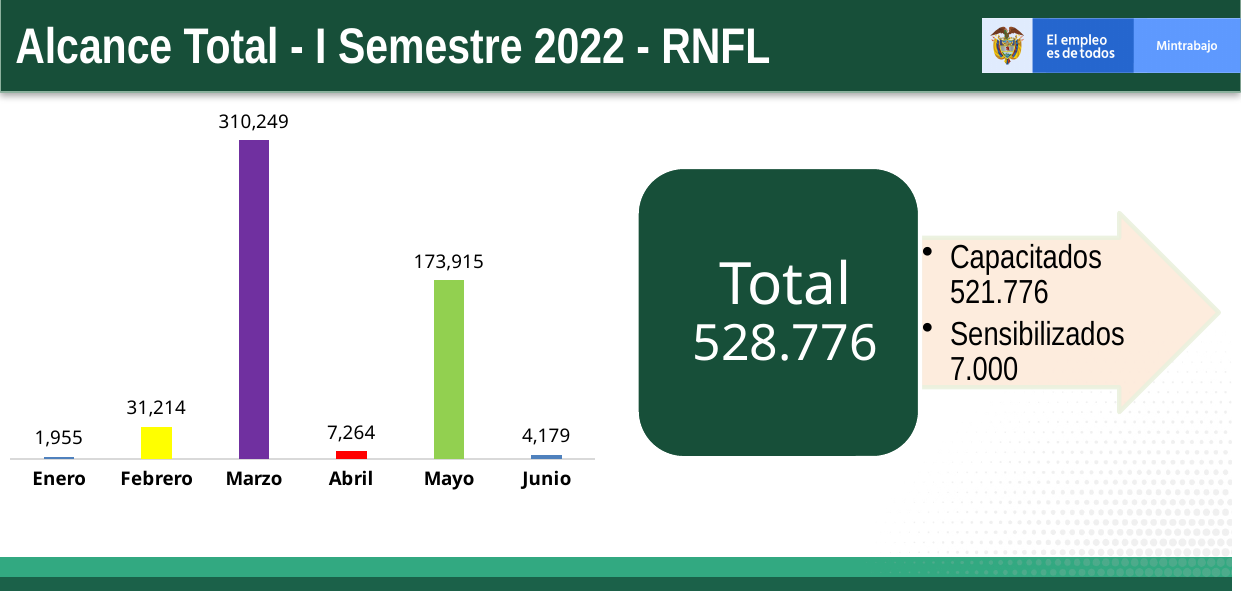
What is the value for Abril in the bar chart? 7,264 Which month has the lowest value in the bar chart? Enero What colour is the bar for Marzo? Purple Which month has the highest value in the bar chart? Marzo What is the value for Marzo in the bar chart? 310,249 What is the difference between the values for Marzo and Mayo? 136,334 How many months are shown in the bar chart? 6 What is the difference between the values for Febrero and Abril? 23,950 What kind of chart is shown on the slide? Bar chart What is the value for Mayo in the bar chart? 173,915 Which is larger, the value for Febrero or the value for Junio? Febrero What is the value for Enero in the bar chart? 1,955